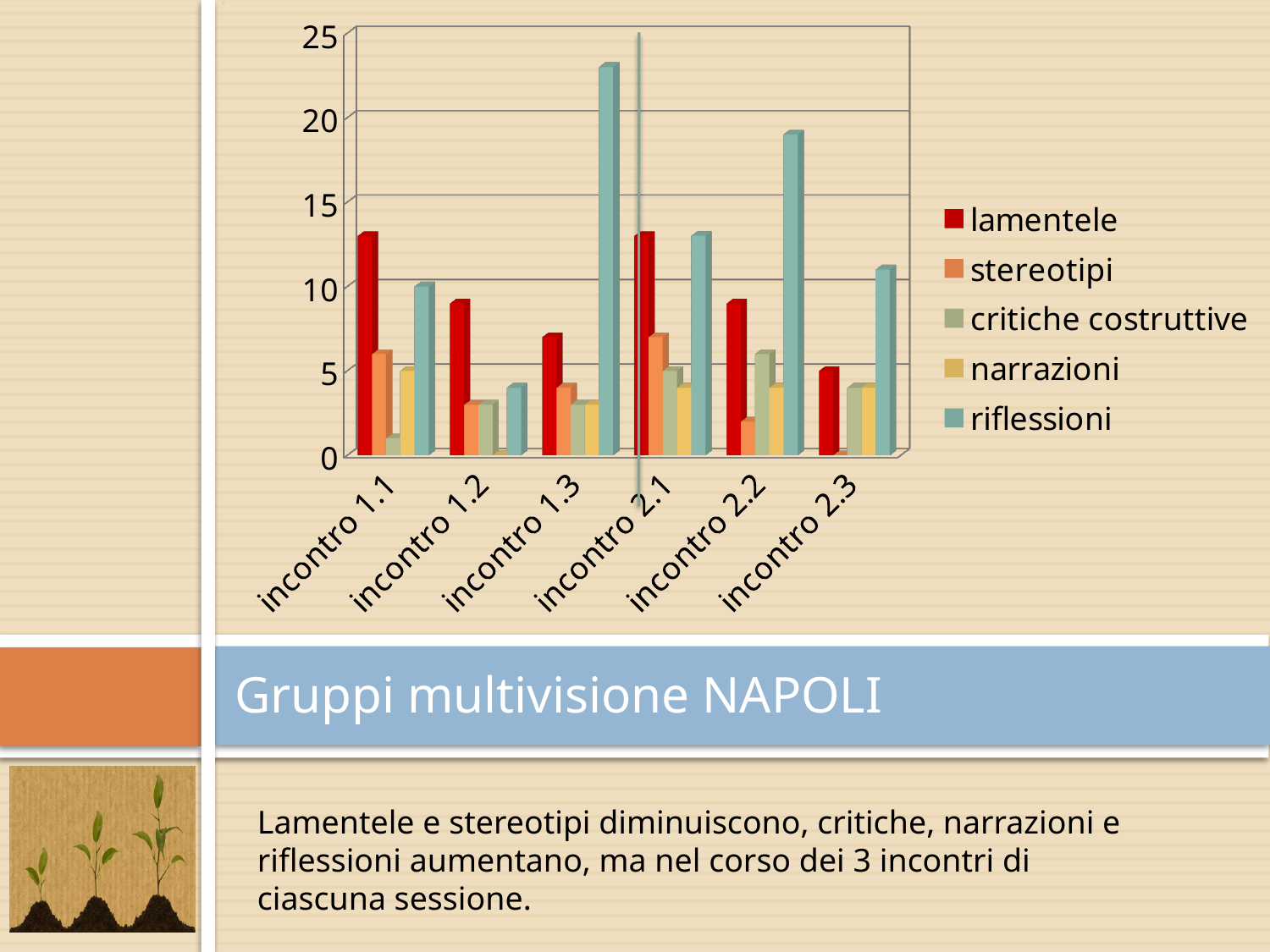
Is the riflessioni value for incontro 1.3 greater or less than 20? greater Is the lamentele value for incontro 1.1 greater or less than 10? greater In incontro 1.2, which is larger: lamentele or riflessioni? lamentele For which incontro is the riflessioni bar the highest? incontro 1.3 Do the lamentele values rise or fall from incontro 1.1 to incontro 1.3? fall In incontro 2.2, which is larger: riflessioni or lamentele? riflessioni What colour represents the lamentele series in the legend? red Is the riflessioni value for incontro 2.2 greater or less than 15? greater How many incontro categories are shown on the x axis of the chart? 6 For which incontro is the lamentele bar the lowest? incontro 2.3 What kind of chart is shown on the slide? bar chart How many series does the chart's legend list? 5